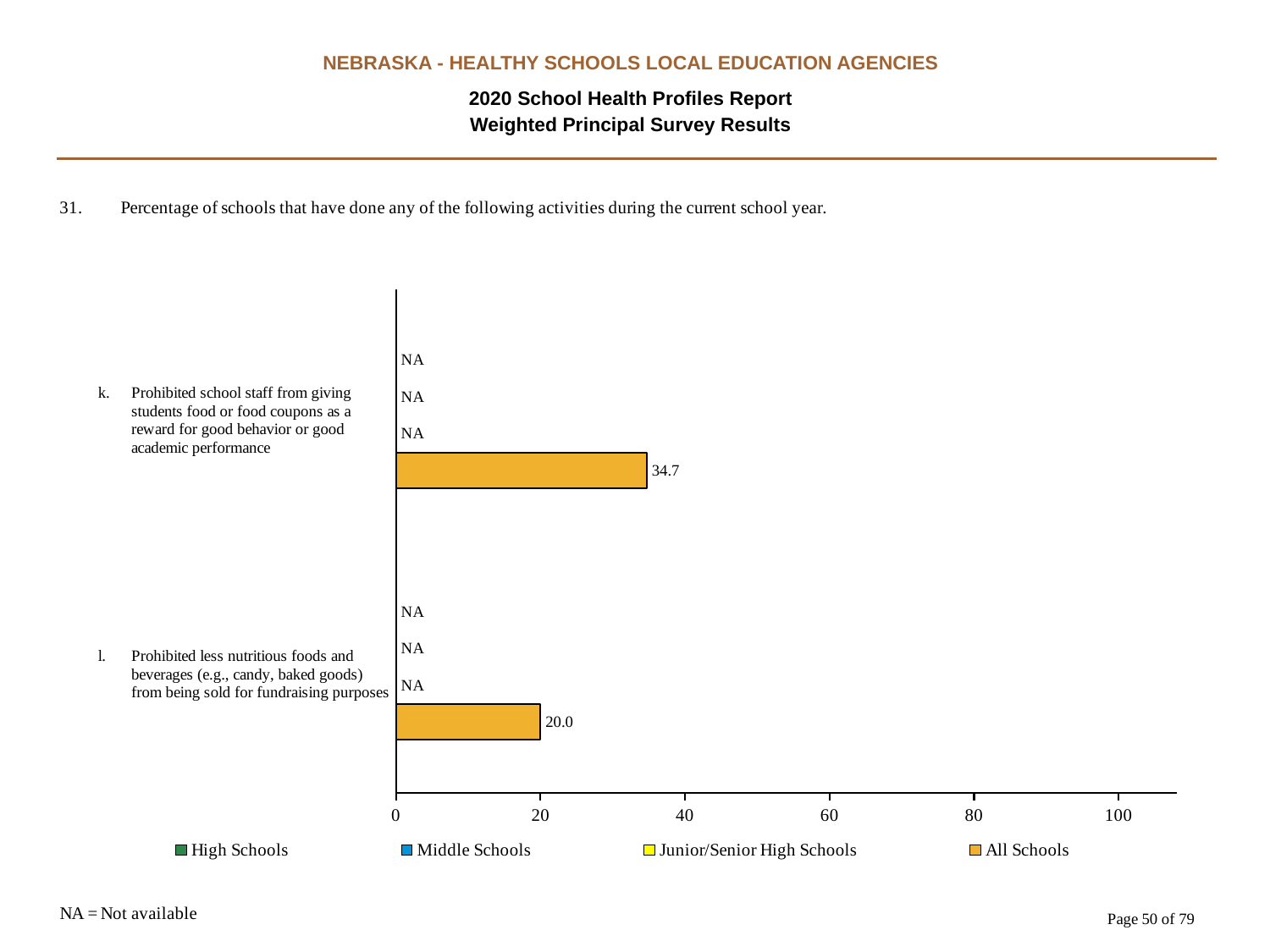
What is the difference between the All Schools values for item k and item l? 14.7 What is the All Schools value for item k, prohibiting school staff from giving students food or food coupons as a reward? 34.7 What does NA stand for according to the note on the slide? Not available What is the Middle Schools value shown for item l? NA What is the All Schools value for item l, prohibiting less nutritious foods and beverages from being sold for fundraising purposes? 20.0 How many series does the legend list? 4 What is the maximum value shown on the x axis? 100 How many activity items are shown on the chart? 2 What is the High Schools value shown for item k? NA Is the All Schools value for item k greater or less than 40? less What kind of chart is shown on the slide? bar chart Which item has the higher All Schools value, k or l? k